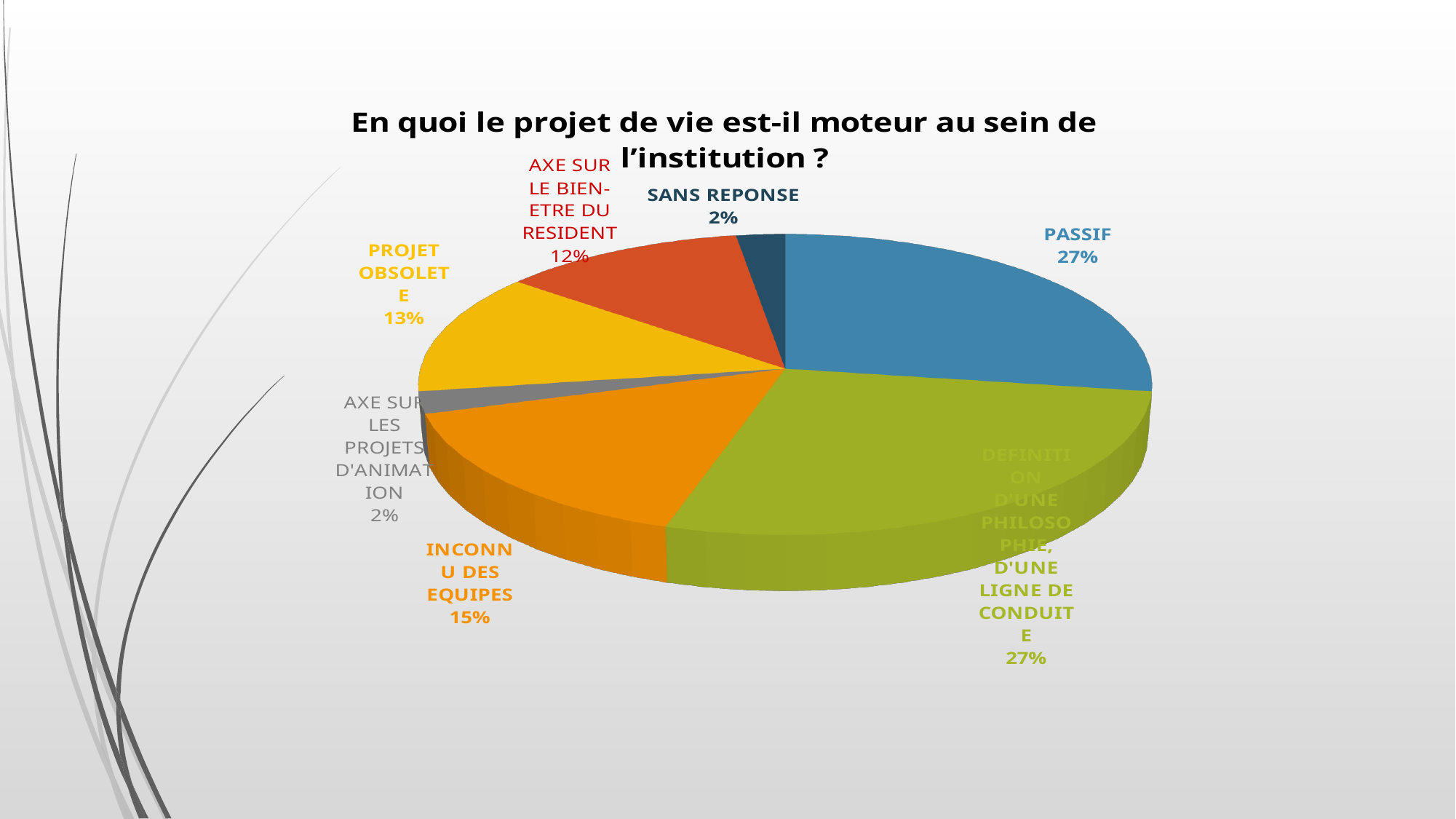
Which is larger, the share for PASSIF or the share for INCONNU DES EQUIPES? PASSIF What kind of chart is shown on the slide? pie chart What colour is the PASSIF slice? blue What share of the pie is AXE SUR LE BIEN-ETRE DU RESIDENT? 12% What is the difference in percentage points between PASSIF and INCONNU DES EQUIPES? 12 What share of the pie is INCONNU DES EQUIPES? 15% What share of the pie is PROJET OBSOLETE? 13% What is the title of the chart? En quoi le projet de vie est-il moteur au sein de l'institution ? How many slices does the pie chart have? 7